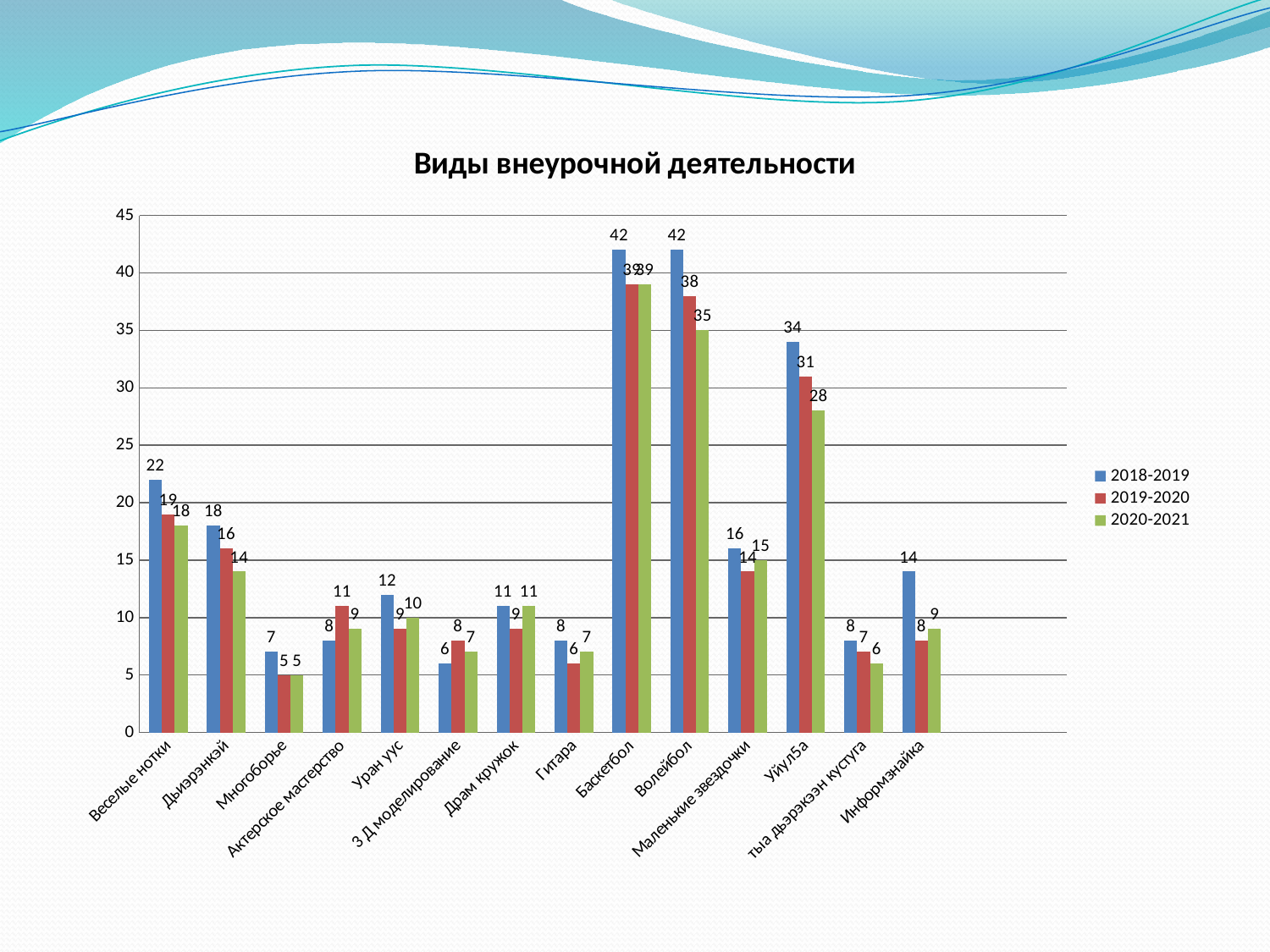
Do the values for Уйулба rise or fall from 2018-2019 to 2020-2021? fall What is the difference between the 2018-2019 and 2020-2021 values for Веселые нотки? 4 In the 2018-2019 series, which is larger: Уран уус or Драм кружок? Уран уус Which category has the lowest value in the 2018-2019 series? 3 Д моделирование Which category has the highest value in the 2020-2021 series? Баскетбол How many categories are shown on the x axis? 14 What is the value for Уйулба in the 2020-2021 series? 28 How many series does the legend list? 3 What is the value for Волейбол in the 2019-2020 series? 38 What kind of chart is shown on the slide? bar chart What is the value for Информэнайка in the 2018-2019 series? 14 Is the 2018-2019 value for Уйулба greater or less than 30? greater